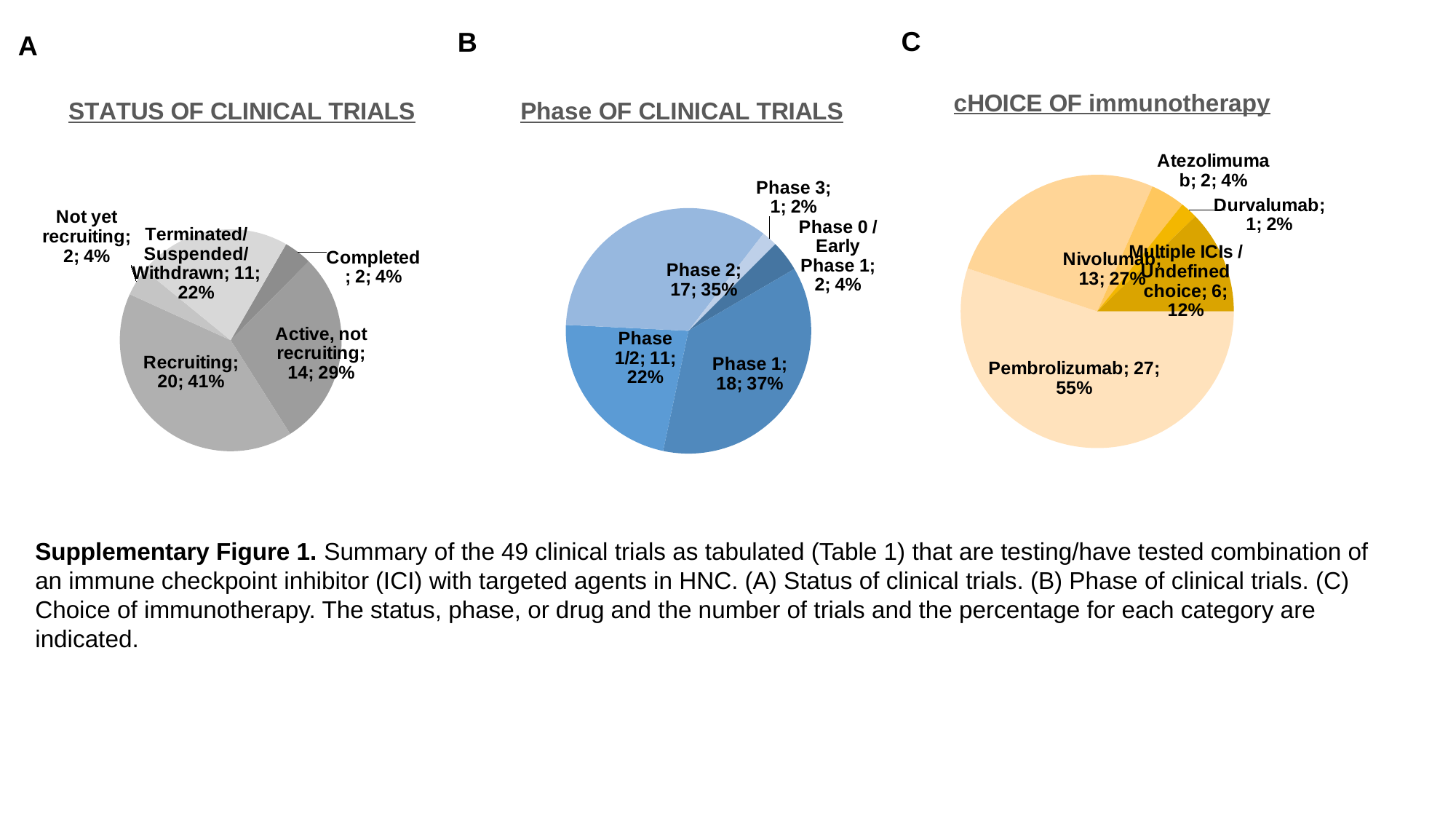
In the 'STATUS OF CLINICAL TRIALS' chart, which status has the largest slice? Recruiting In the 'Phase OF CLINICAL TRIALS' chart, what percentage share do Phase 1 trials have? 37% In the 'Phase OF CLINICAL TRIALS' chart, how many trials are Phase 2? 17 In the 'cHOICE OF immunotherapy' chart, how many trials use Pembrolizumab? 27 In the 'Phase OF CLINICAL TRIALS' chart, which phase has the smallest slice? Phase 3 In the 'cHOICE OF immunotherapy' chart, what is the difference in number of trials between Pembrolizumab and Nivolumab? 14 In the 'STATUS OF CLINICAL TRIALS' chart, what percentage share do Active, not recruiting trials have? 29% In the 'STATUS OF CLINICAL TRIALS' chart, how many trials are Recruiting? 20 In the 'STATUS OF CLINICAL TRIALS' chart, how many categories are shown? 5 What type of chart is used for the 'STATUS OF CLINICAL TRIALS' chart? Pie chart In the 'Phase OF CLINICAL TRIALS' chart, what is the difference in number of trials between Phase 1 and Phase 1/2? 7 In the 'cHOICE OF immunotherapy' chart, which is larger: Nivolumab or Multiple ICIs / Undefined choice? Nivolumab